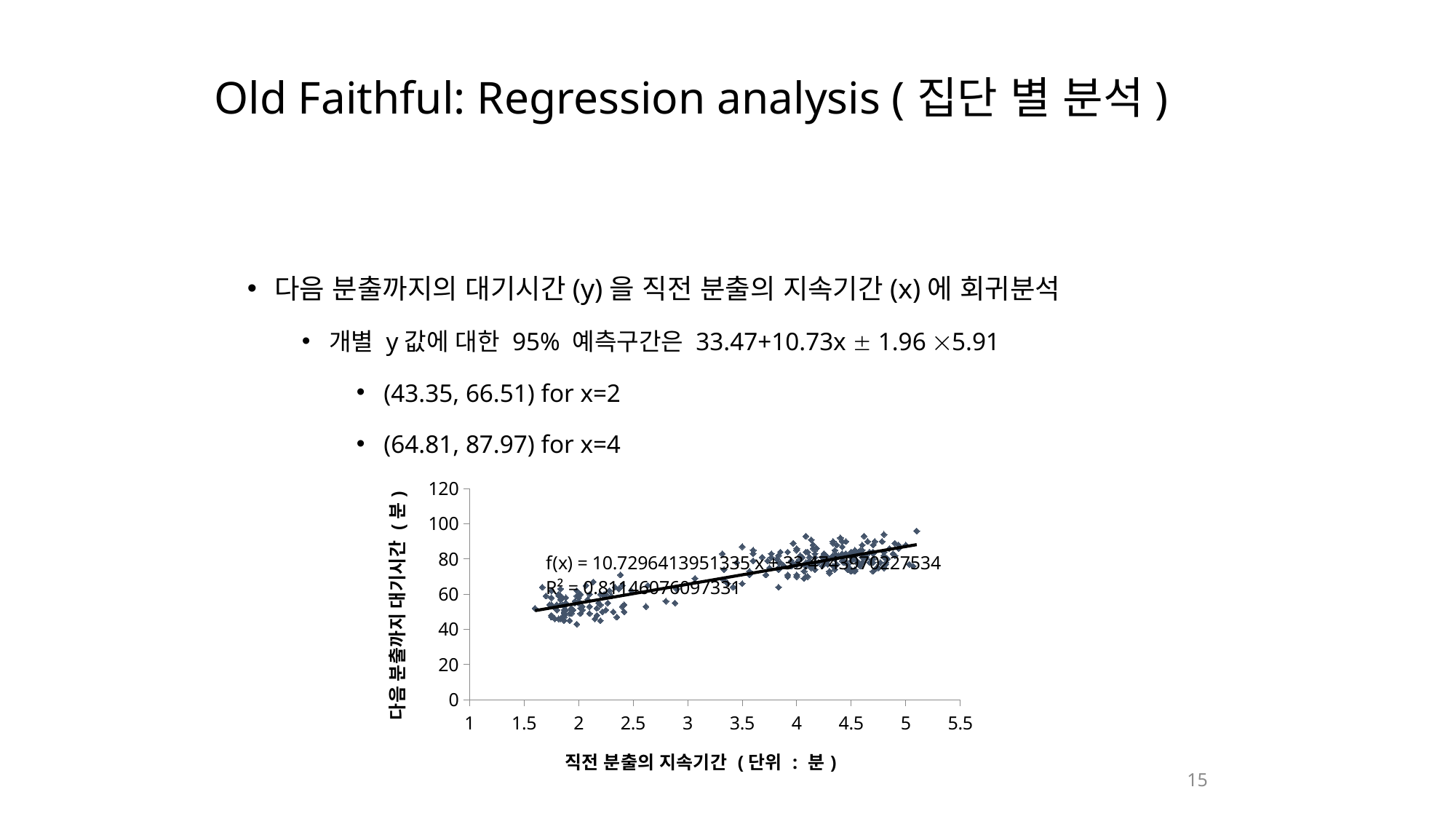
What is the slope of the fitted trendline shown in the chart's equation label? 10.7296413951335 What kind of chart is shown on the slide? scatter plot Is the trendline value at x = 5 greater or less than 80? greater What R² value is displayed on the chart? 0.811460760097331 What is the highest tick value shown on the y axis? 120 Are the plotted points near x = 4.5 greater or less than 60 on the y axis? greater Is the trendline value at x = 2 greater or less than 80? less What is the largest tick value shown on the x axis? 5.5 Which group of points has higher y values: those near x = 2 or those near x = 4.5? those near x = 4.5 Do the plotted points generally rise or fall as the x-axis value increases? rise